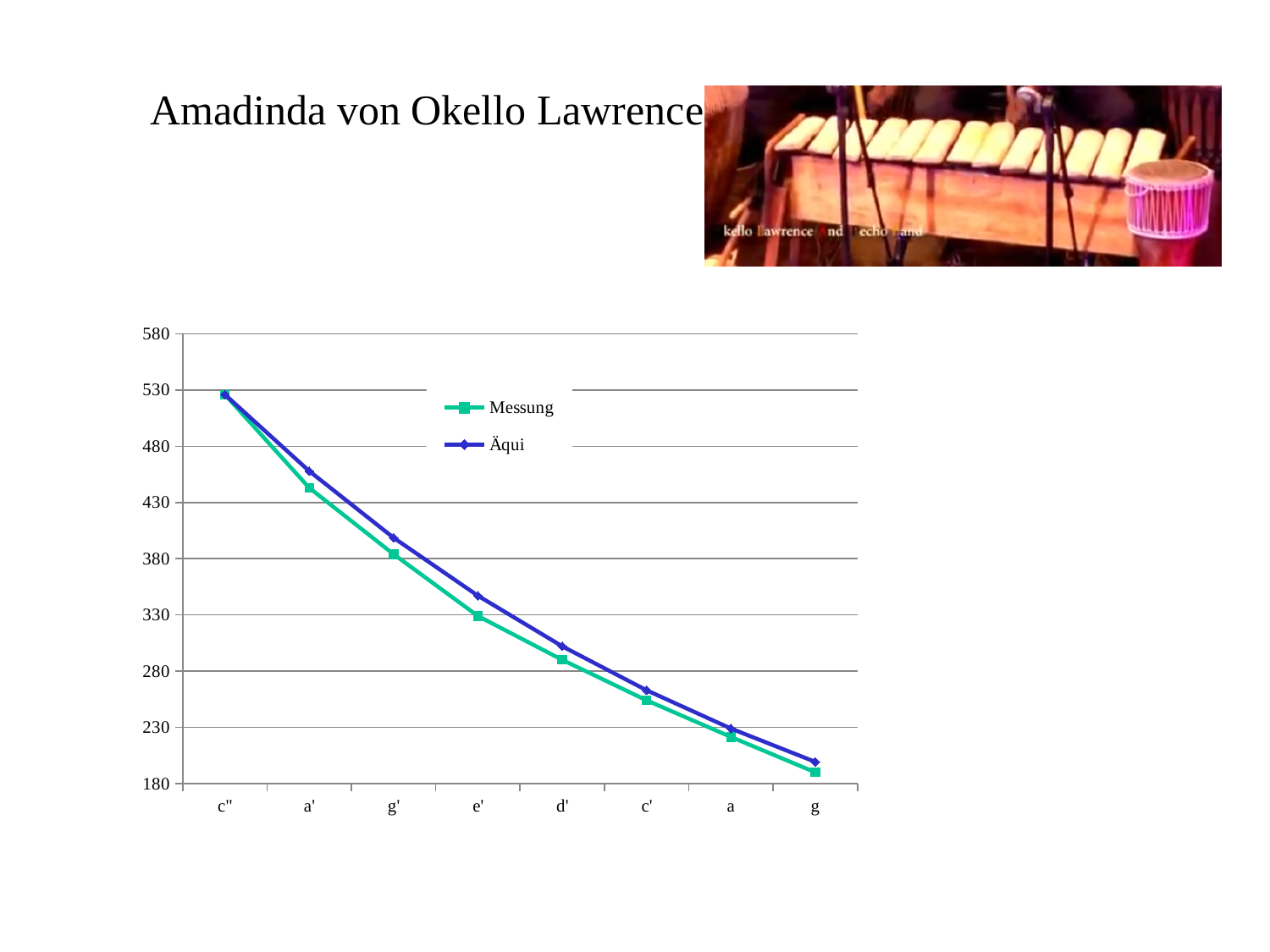
What kind of chart is shown on the slide? line chart Is the Äqui value for g greater or less than 230? less At which category does the Äqui series reach its highest value? c'' Do the values of the Messung series rise or fall from c'' to g along the x axis? fall At e', which series has the larger value, Messung or Äqui? Äqui Is the Messung value for c' greater or less than 280? less How many series does the chart's legend list? 2 Which series are listed in the chart's legend? Messung and Äqui Is the Äqui value for e' greater or less than 330? greater How many categories are shown along the x axis of the chart? 8 At which category does the Messung series reach its lowest value? g